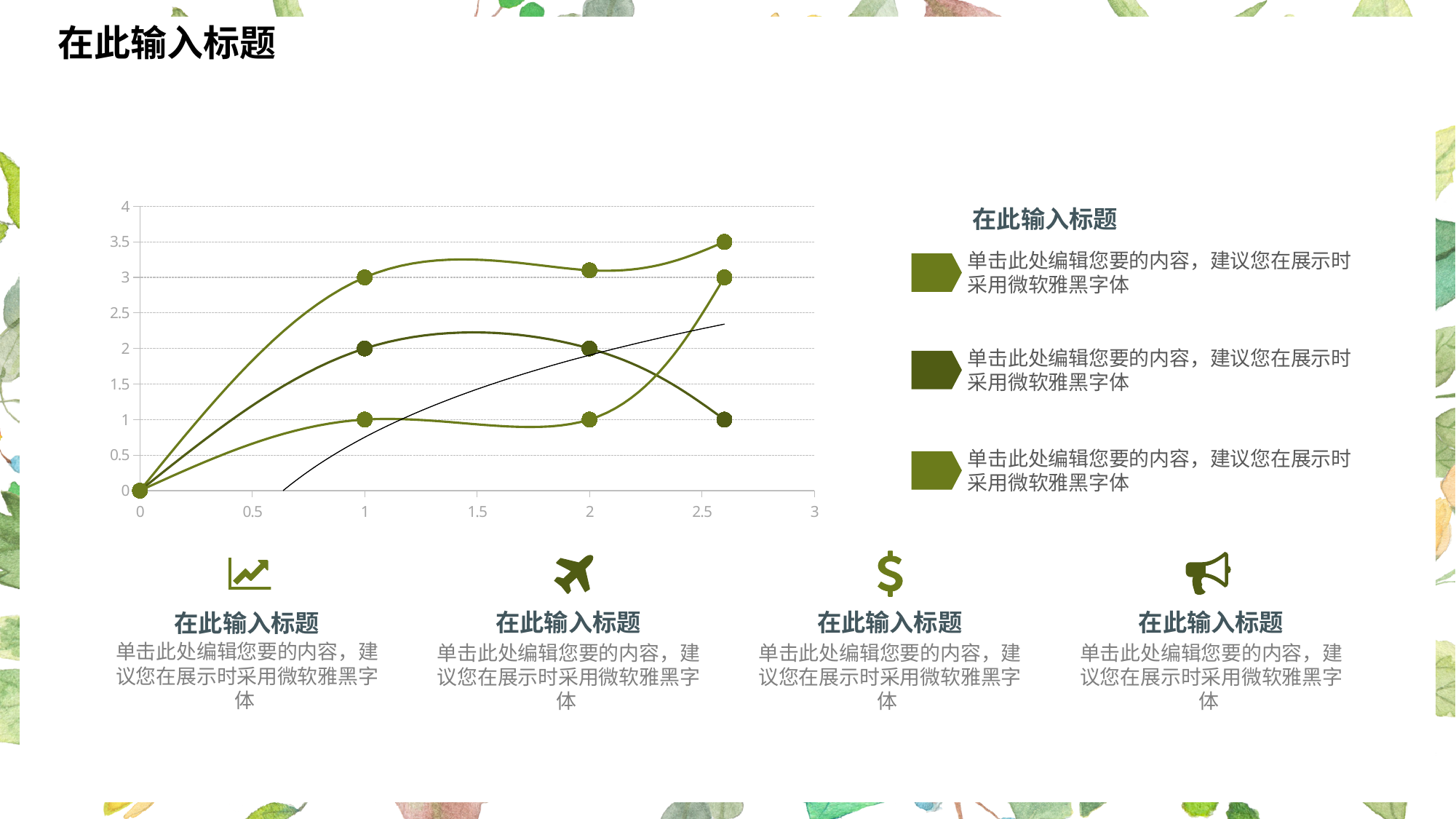
Does the topmost line rise or fall between x = 0 and x = 1? rise What is the highest value shown on the horizontal axis of the chart? 3 What is the y value of the highest plotted point at x = 1? 3 Is the y value of the highest plotted point on the chart greater or less than 3? greater What is the y value of the middle plotted point at x = 1? 2 What is the y value of the middle plotted point at x = 2? 2 Is the y value of the highest plotted point at x = 2 greater or less than 2.5? greater How many plotted points are there at x = 1? 3 What is the highest value shown on the vertical axis of the chart? 4 What is the y value of the lowest plotted point at x = 1? 1 What is the y value of the lowest plotted point at x = 2? 1 What kind of chart is shown on the slide? scatter chart with smoothed lines